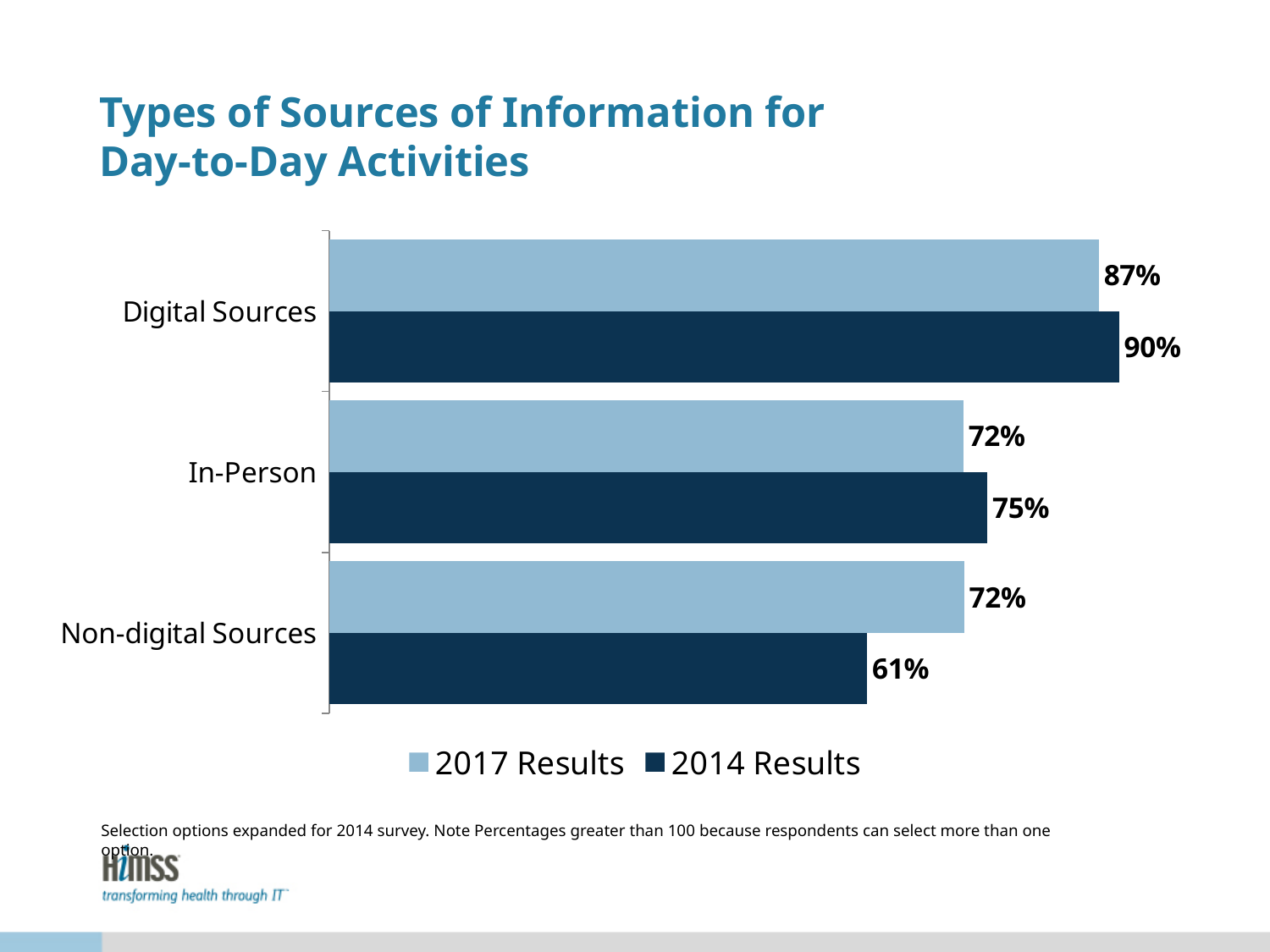
Which category has the highest 2014 Results value? Digital Sources What is the 2017 Results value for Digital Sources? 87% What is the 2014 Results value for Non-digital Sources? 61% What kind of chart is shown on the slide? Bar chart Which series is shown in the dark navy colour? 2014 Results What is the difference between the 2014 and 2017 Results for Digital Sources? 3% How many series does the legend list? 2 What is the 2014 Results value for In-Person? 75% What is the difference between the 2014 and 2017 Results for Non-digital Sources? 11% Which category has the lowest 2014 Results value? Non-digital Sources For In-Person, which is larger: the 2017 Results or the 2014 Results? 2014 Results How many categories are shown on the chart? 3